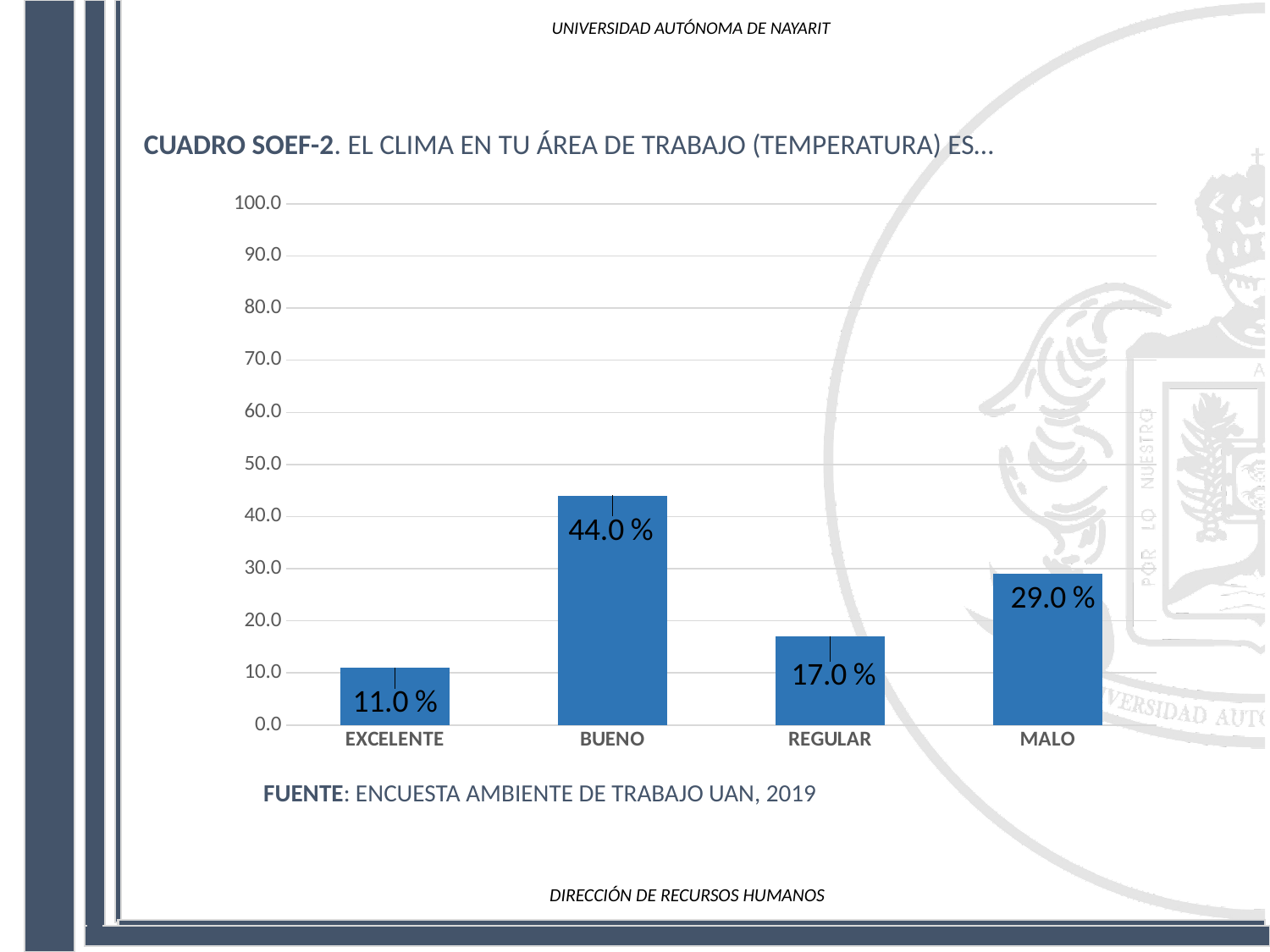
Which category has the highest value? BUENO What is the value for EXCELENTE? 11.0 % What is the value for BUENO? 44.0 % Which is larger, the value for REGULAR or the value for MALO? MALO What is the difference between the values for BUENO and MALO? 15.0 % Which category has the lowest value? EXCELENTE What source is cited below the chart? ENCUESTA AMBIENTE DE TRABAJO UAN, 2019 What is the value for MALO? 29.0 % How many categories are shown on the x axis? 4 What is the value for REGULAR? 17.0 % What kind of chart is shown on the slide? bar chart Is the value for BUENO greater or less than 50.0? less